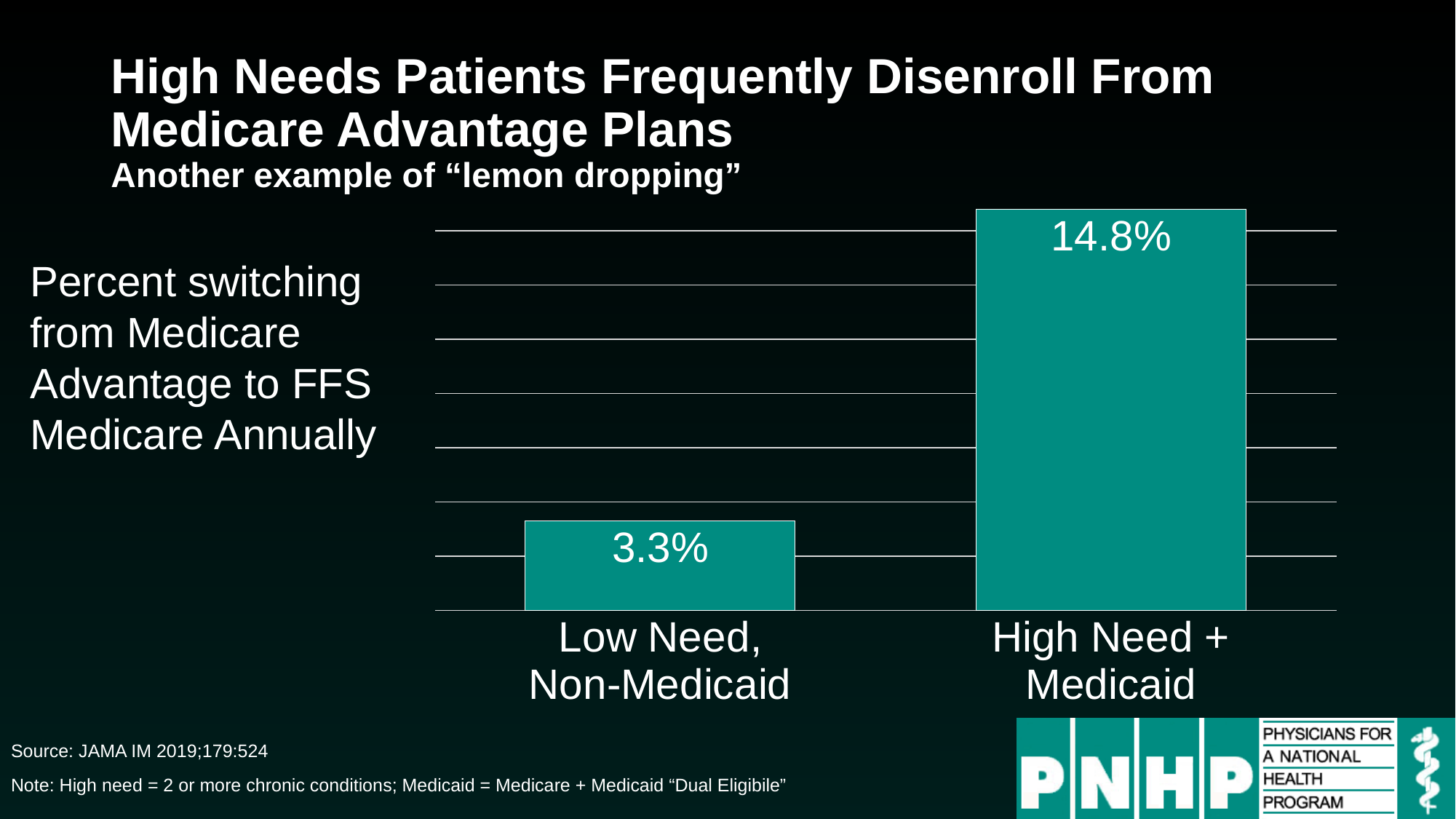
What is the difference between the High Need + Medicaid value and the Low Need, Non-Medicaid value? 11.5% Which category has the highest value? High Need + Medicaid What is the value for High Need + Medicaid? 14.8% What does the chart measure, according to the text to the left of it? Percent switching from Medicare Advantage to FFS Medicare Annually What is the source cited for the chart? JAMA IM 2019;179:524 How many categories are shown in the chart? 2 What is the value for Low Need, Non-Medicaid? 3.3% What kind of chart is shown on the slide? Bar chart Which category has the lowest value? Low Need, Non-Medicaid Which is larger, the value for Low Need, Non-Medicaid or the value for High Need + Medicaid? High Need + Medicaid